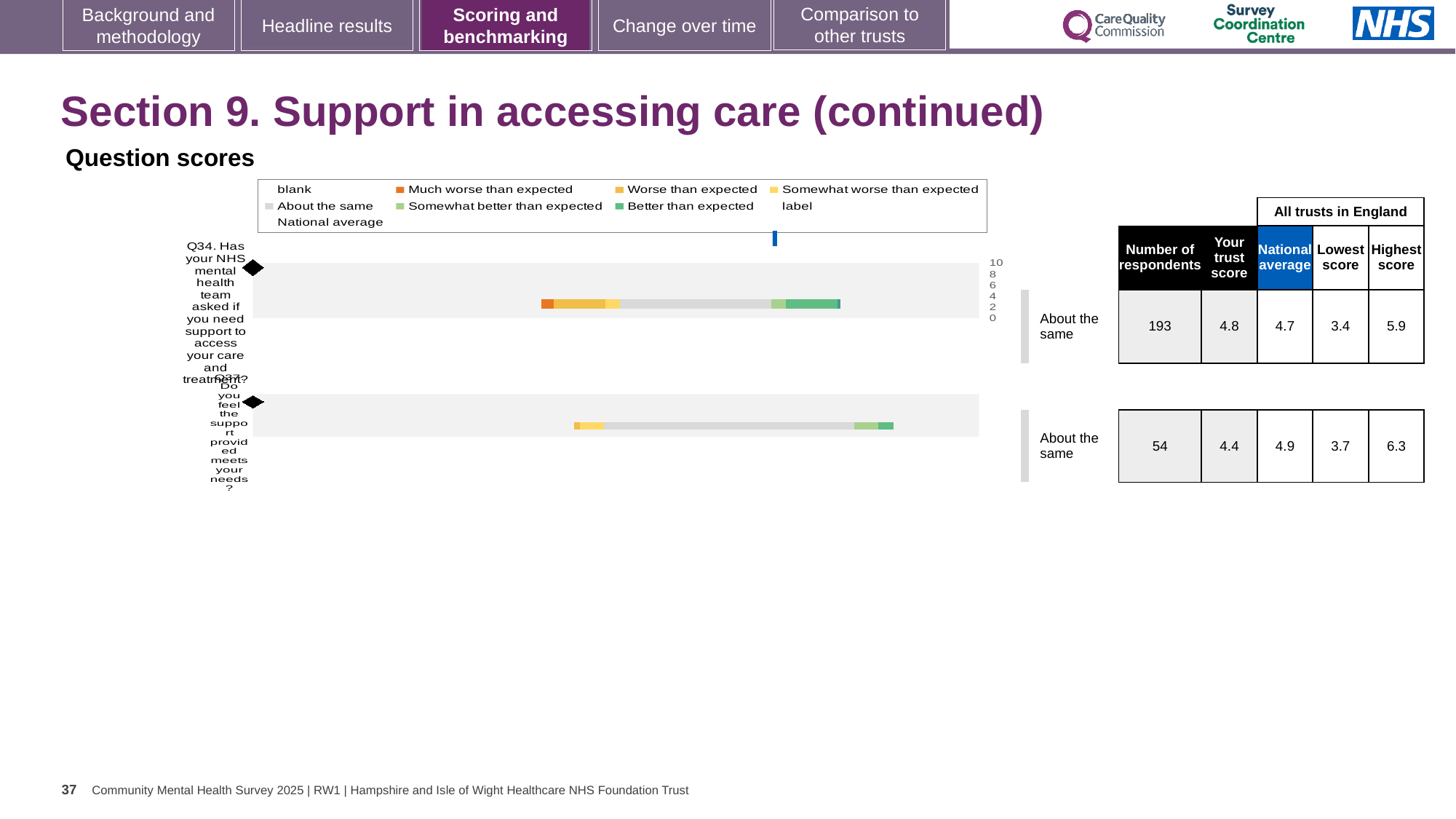
Which benchmark category is shown for Q34? About the same What is the difference between the highest and lowest scores for Q34? 2.5 What is the highest score among all trusts in England for Q37? 6.3 How many questions are plotted in the question scores chart? 2 Is the trust score for Q37 higher or lower than the national average? lower What kind of chart is used to show the question scores on this slide? bar chart What is the trust score for Q34 (Has your NHS mental health team asked if you need support to access your care and treatment)? 4.8 What is the national average score for Q37 (Do you feel the support provided meets your needs)? 4.9 What is the difference in the number of respondents between Q34 and Q37? 139 Which question has more respondents, Q34 or Q37? Q34 What is the lowest score among all trusts in England for Q34? 3.4 What is the number of respondents for Q34 in the question scores table? 193